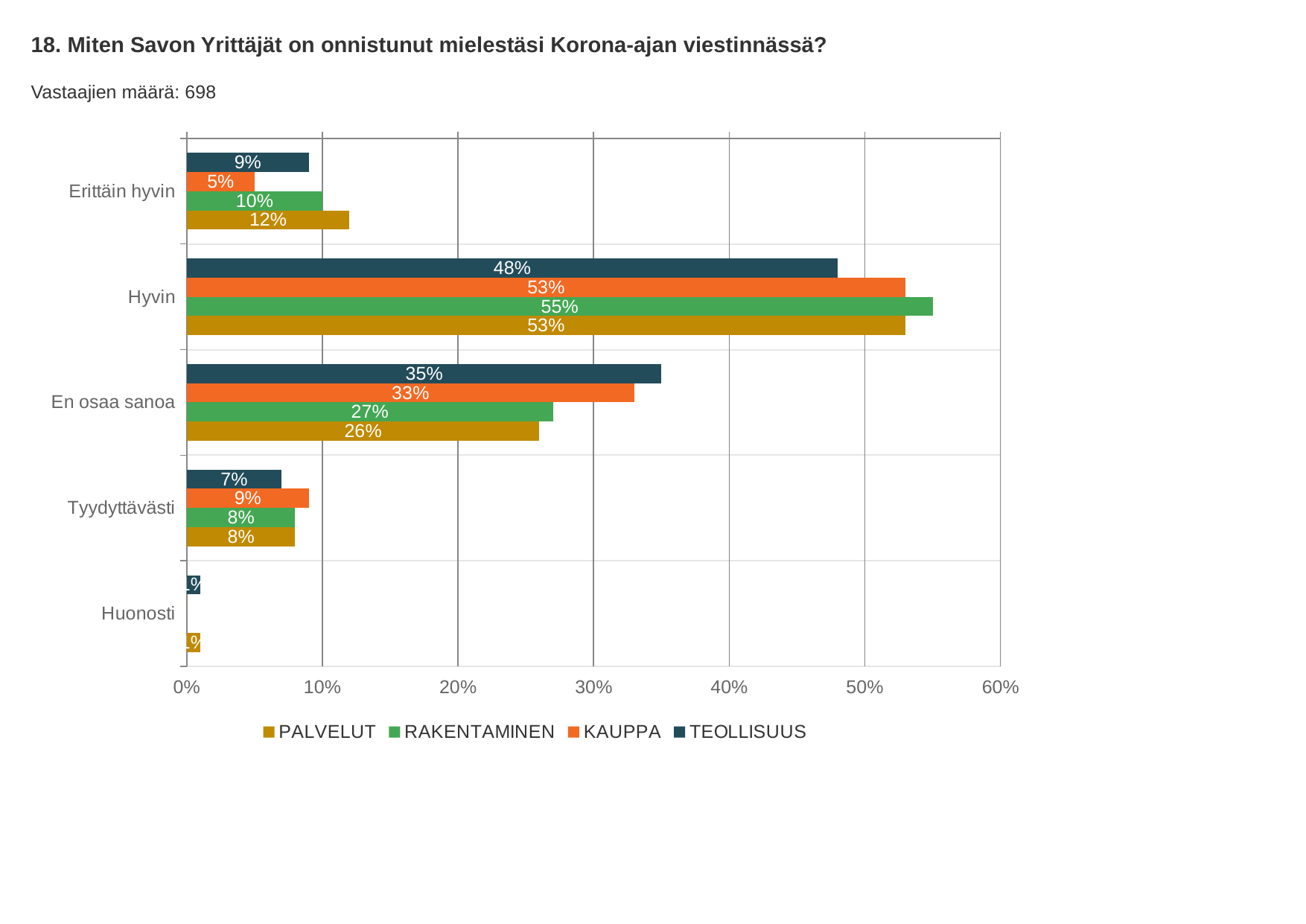
What is the value for RAKENTAMINEN in the Tyydyttävästi category? 8% Which series has the lowest value in the Erittäin hyvin category? KAUPPA Is the value for RAKENTAMINEN in the Hyvin category greater or less than 50%? greater How many series does the legend list? 4 What is the value for KAUPPA in the En osaa sanoa category? 33% What is the value for TEOLLISUUS in the Hyvin category? 48% What is the value for PALVELUT in the Erittäin hyvin category? 12% What is the difference between the TEOLLISUUS and PALVELUT values in the En osaa sanoa category? 9% How many response categories are shown on the vertical axis? 5 Which series has the highest value in the Hyvin category? RAKENTAMINEN In the Tyydyttävästi category, which is larger: the KAUPPA value or the TEOLLISUUS value? KAUPPA What kind of chart is shown on the slide? Bar chart